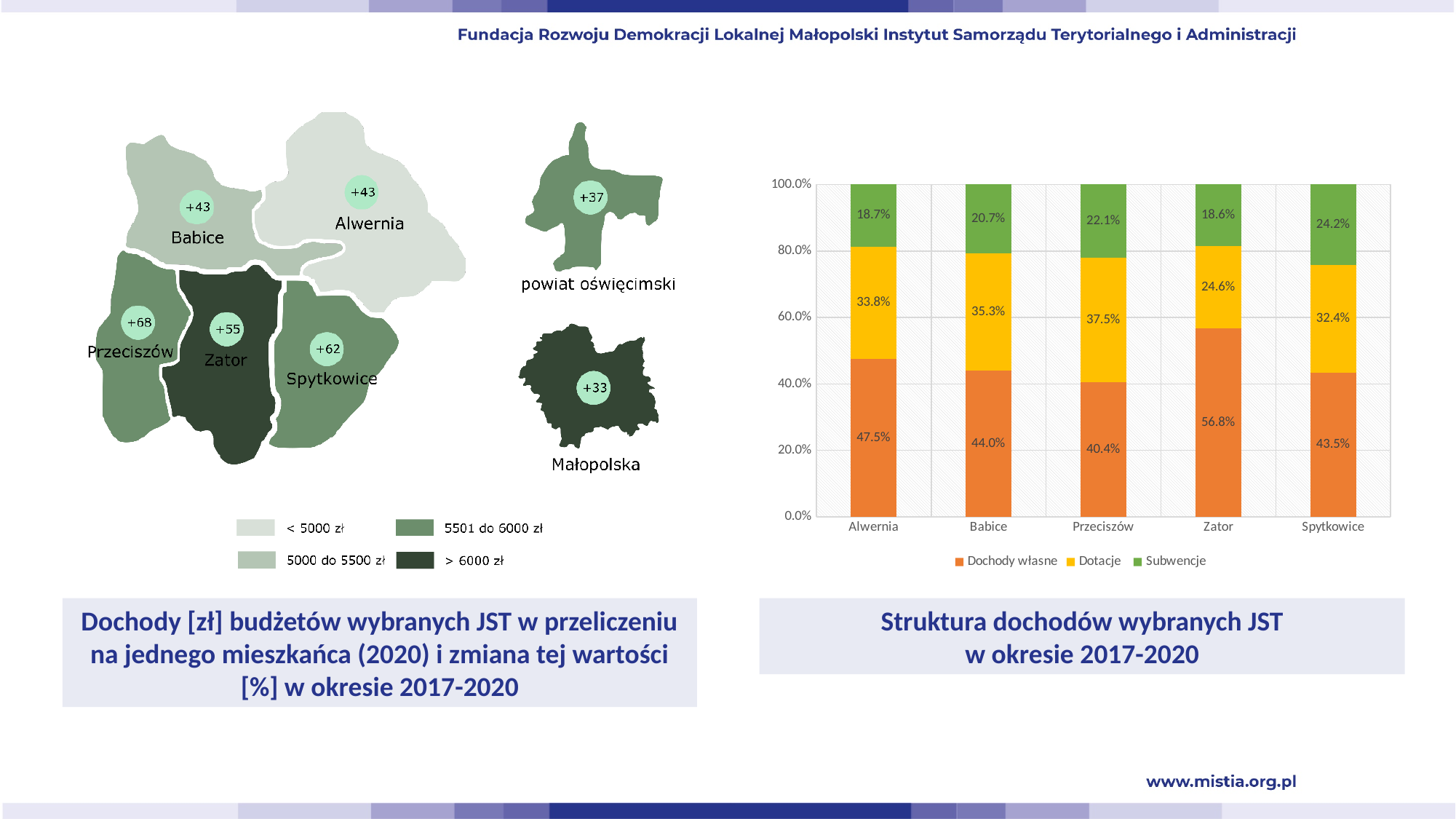
In the stacked bar chart, which municipality has the highest share of Dochody własne? Zator How many series does the legend of the stacked bar chart list? 3 In the stacked bar chart, which municipality has the highest share of Subwencje? Spytkowice What type of chart is used to show the structure of incomes (Struktura dochodów wybranych JST)? Stacked bar chart How many municipalities are shown on the x axis of the stacked bar chart? 5 In the stacked bar chart, what is the share of Dotacje for Przeciszów? 37.5% In the stacked bar chart, by how many percentage points does the Dochody własne share of Zator exceed that of Przeciszów? 16.4 percentage points In the stacked bar chart, which has a larger Dotacje share, Babice or Alwernia? Babice In the stacked bar chart, which municipality has the lowest share of Dotacje? Zator In the stacked bar chart, what is the share of Dochody własne for Zator? 56.8% In the stacked bar chart, which series is shown in green? Subwencje In the stacked bar chart, what is the share of Subwencje for Spytkowice? 24.2%